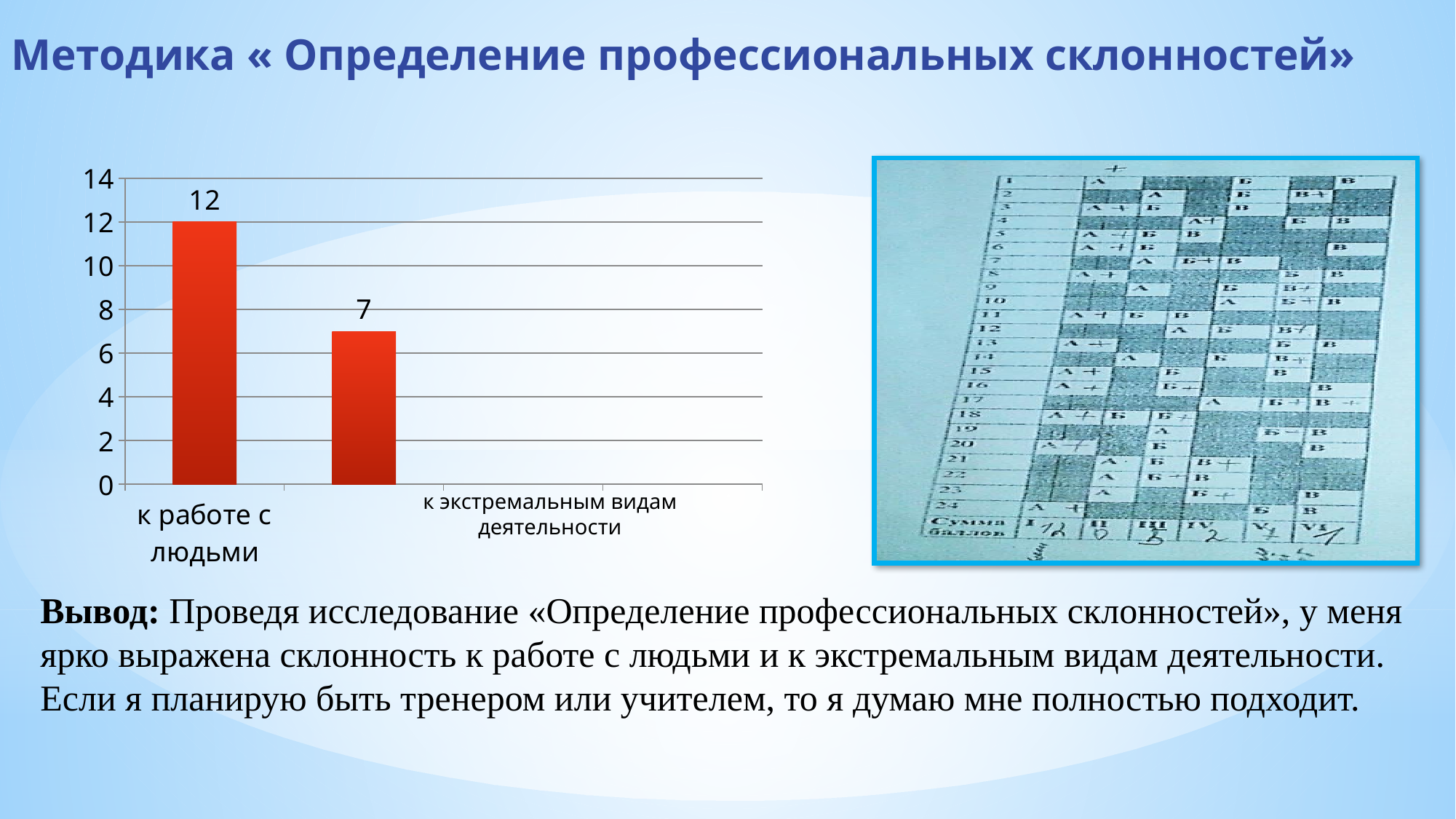
How many bars are plotted in the chart? 2 Which is larger: the value for «к работе с людьми» or for «к экстремальным видам деятельности»? к работе с людьми What colour are the bars in the chart? red What is the maximum value shown on the vertical axis? 14 Which category has the highest value? к работе с людьми What kind of chart is shown on the slide? bar chart Is the value for «к работе с людьми» greater or less than 10? greater What is the value for «к экстремальным видам деятельности»? 7 Which category has the lowest value? к экстремальным видам деятельности Is the value for «к экстремальным видам деятельности» greater or less than 10? less What is the difference between the values for «к работе с людьми» and «к экстремальным видам деятельности»? 5 What is the value for «к работе с людьми»? 12